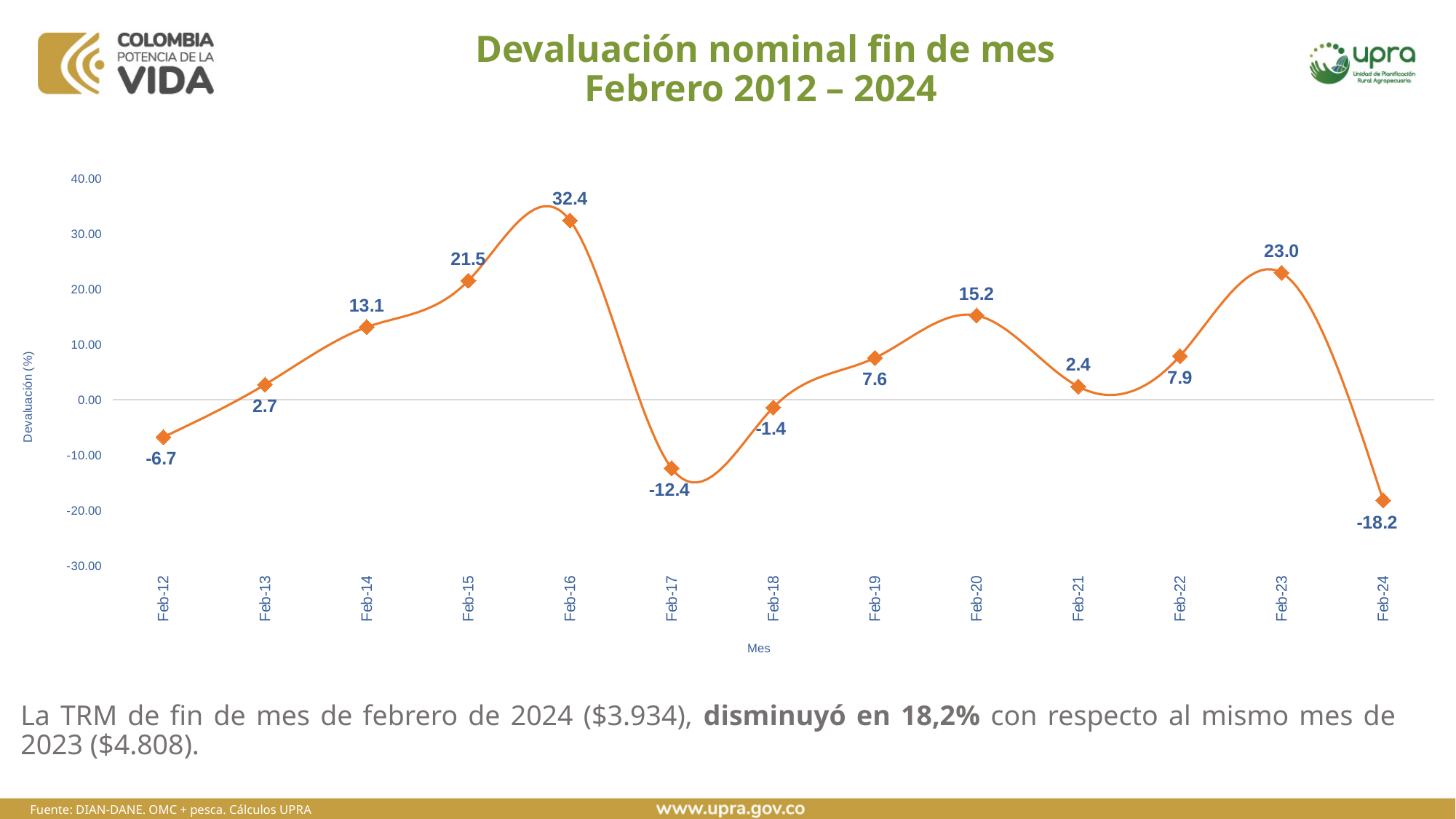
Which month has the highest devaluation value? Feb-16 What is the devaluation value for Feb-21? 2.4 What is the devaluation value for Feb-16? 32.4 What is the devaluation value for Feb-24? -18.2 Which is larger, the value for Feb-20 or the value for Feb-19? Feb-20 What is the difference between the values for Feb-15 and Feb-14? 8.4 What kind of chart is shown on the slide? line chart Does the value rise or fall from Feb-23 to Feb-24? fall How many months are plotted on the chart? 13 What is the difference between the values for Feb-23 and Feb-24? 41.2 Is the value for Feb-17 greater or less than -10.00? less Which month has the lowest devaluation value? Feb-24